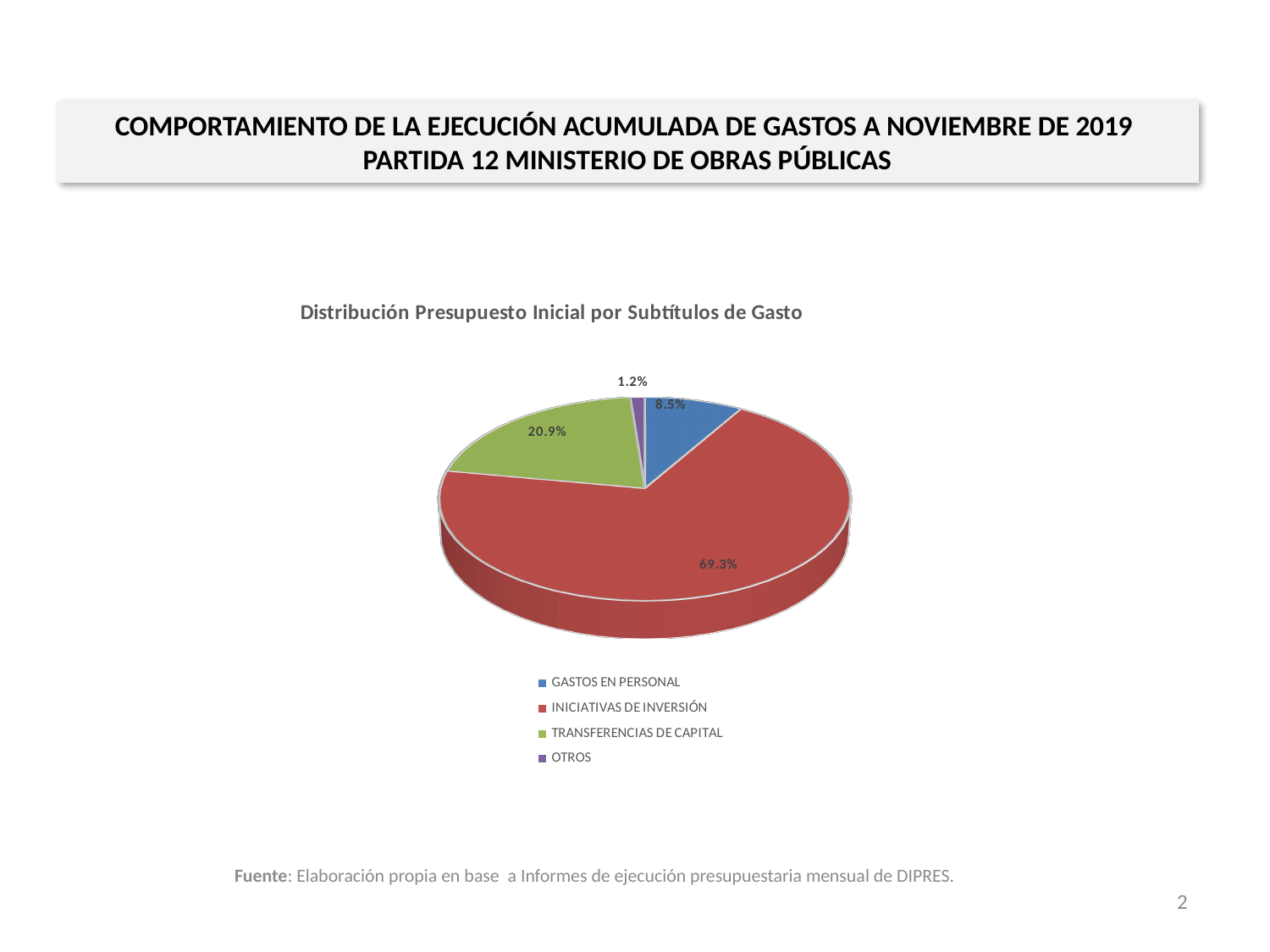
What is the difference in percentage points between INICIATIVAS DE INVERSIÓN and TRANSFERENCIAS DE CAPITAL? 48.4 Which category has the largest slice of the pie? INICIATIVAS DE INVERSIÓN What kind of chart is shown on the slide? Pie chart What share of the pie does OTROS represent? 1.2% What share of the pie does INICIATIVAS DE INVERSIÓN represent? 69.3% What is the title of the chart? Distribución Presupuesto Inicial por Subtítulos de Gasto How many categories does the pie chart show? 4 Which category has the smallest slice of the pie? OTROS Which is larger, the share for GASTOS EN PERSONAL or the share for TRANSFERENCIAS DE CAPITAL? TRANSFERENCIAS DE CAPITAL What colour is the slice for TRANSFERENCIAS DE CAPITAL? Green What share of the pie does TRANSFERENCIAS DE CAPITAL represent? 20.9%